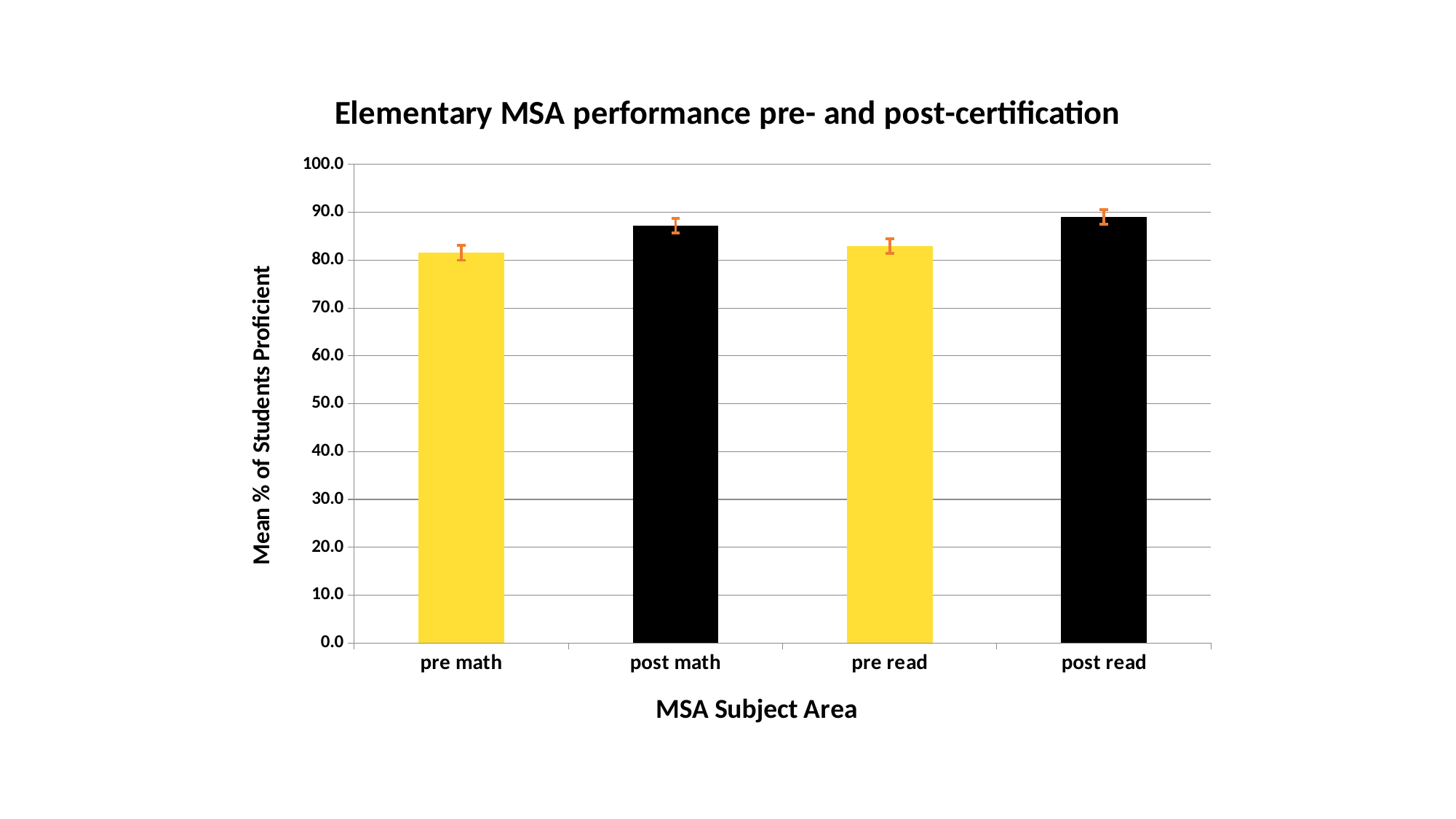
Which is larger, the value for post math or the value for pre math? post math Which is larger, the value for post read or the value for pre read? post read Which is larger, the value for post math or the value for pre read? post math Is the value for pre math greater or less than 80? greater Is the value for pre read greater or less than 80? greater What kind of chart is shown on the slide? bar chart Which category has the highest mean % of students proficient? post read How many categories are plotted on the x axis? 4 Is the value for post read greater or less than 80? greater What is the title of the chart? Elementary MSA performance pre- and post-certification What is the label on the y axis? Mean % of Students Proficient